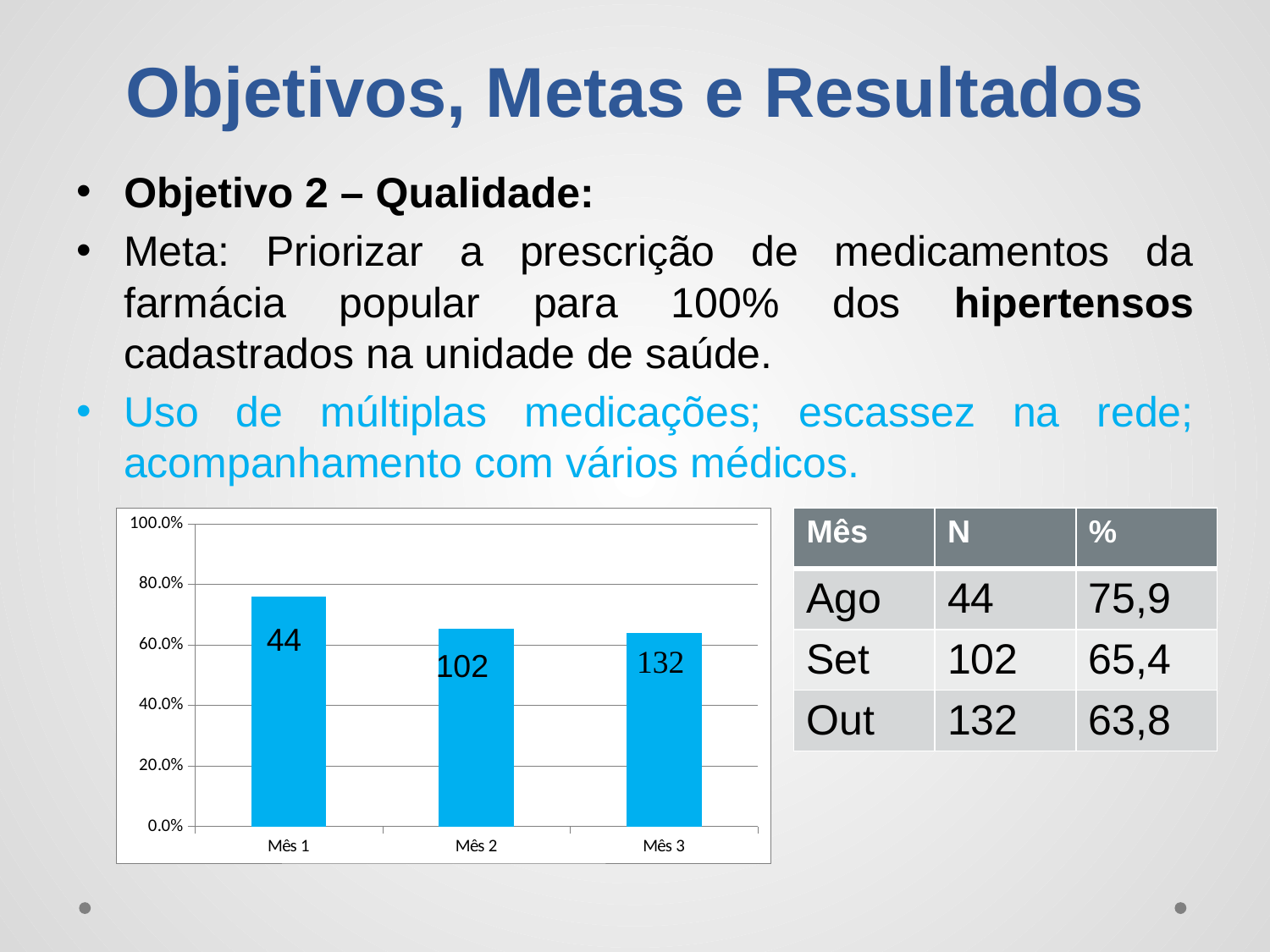
Which bar is taller, Mês 1 or Mês 3? Mês 1 Is the bar for Mês 3 greater or less than 40.0% on the y axis? greater Is the bar for Mês 2 greater or less than 80.0% on the y axis? less Do the bar heights rise or fall from Mês 1 to Mês 3? fall What kind of chart is shown on the slide? bar chart How many bars (categories) does the chart show? 3 What data label is printed on the bar for Mês 3? 132 What is the difference between the data labels printed on the bars for Mês 3 and Mês 1? 88 Which category has the tallest bar in the chart? Mês 1 What data label is printed on the bar for Mês 2? 102 What data label is printed on the bar for Mês 1? 44 Is the bar for Mês 1 greater or less than 60.0% on the y axis? greater